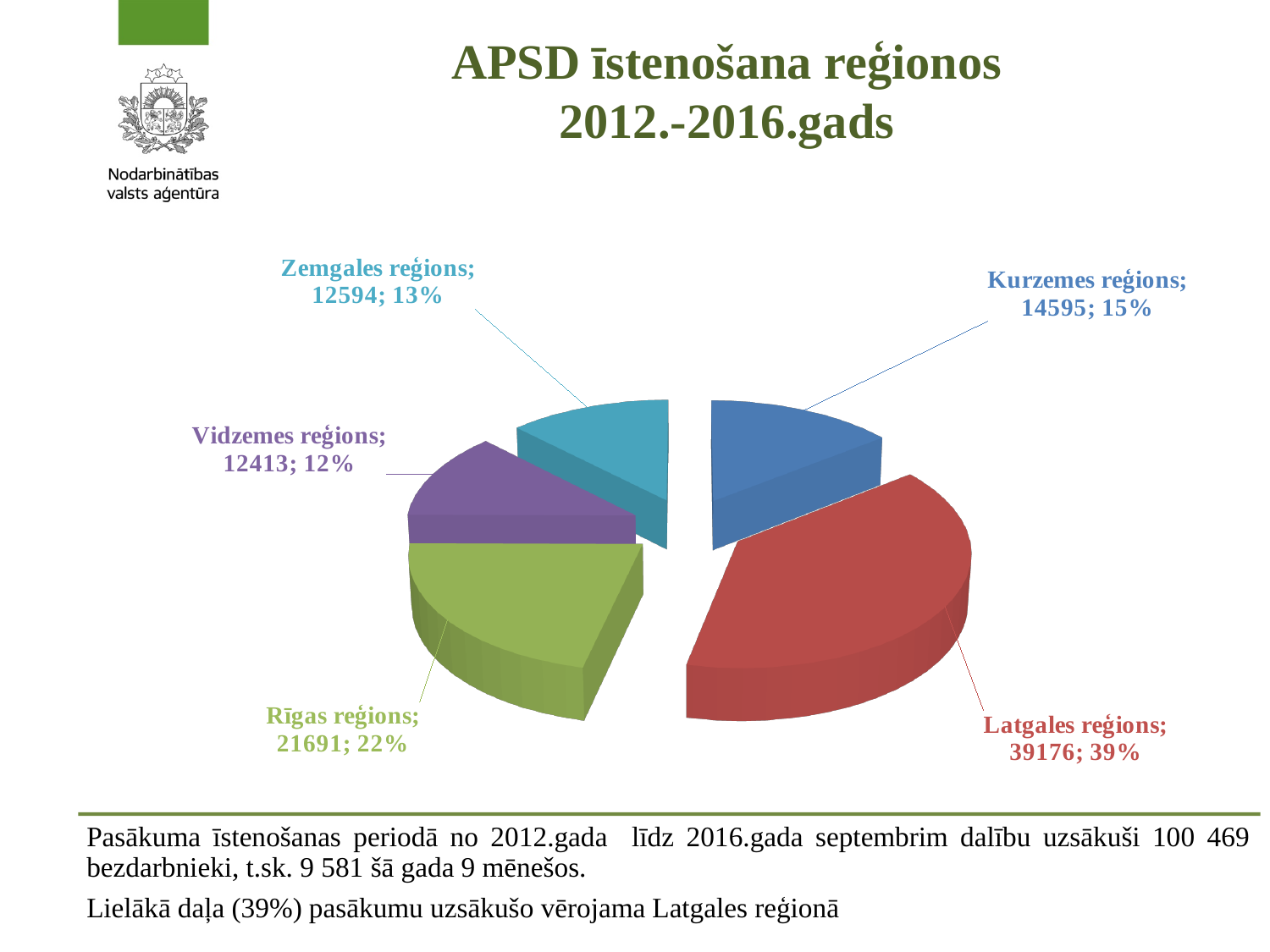
Which region has the largest slice of the pie? Latgales reģions What is the value for Kurzemes reģions? 14595 How many regions (slices) does the pie chart show? 5 Which region has the smallest slice of the pie? Vidzemes reģions What is the value for Latgales reģions? 39176 What share of the pie does Zemgales reģions represent? 13% What type of chart is shown on the slide? pie chart What share of the pie does Rīgas reģions represent? 22% What is the difference between the values for Latgales reģions and Rīgas reģions? 17485 Which is larger, the value for Kurzemes reģions or the value for Zemgales reģions? Kurzemes reģions What is the title of the chart on the slide? APSD īstenošana reģionos 2012.-2016.gads What is the value for Vidzemes reģions? 12413